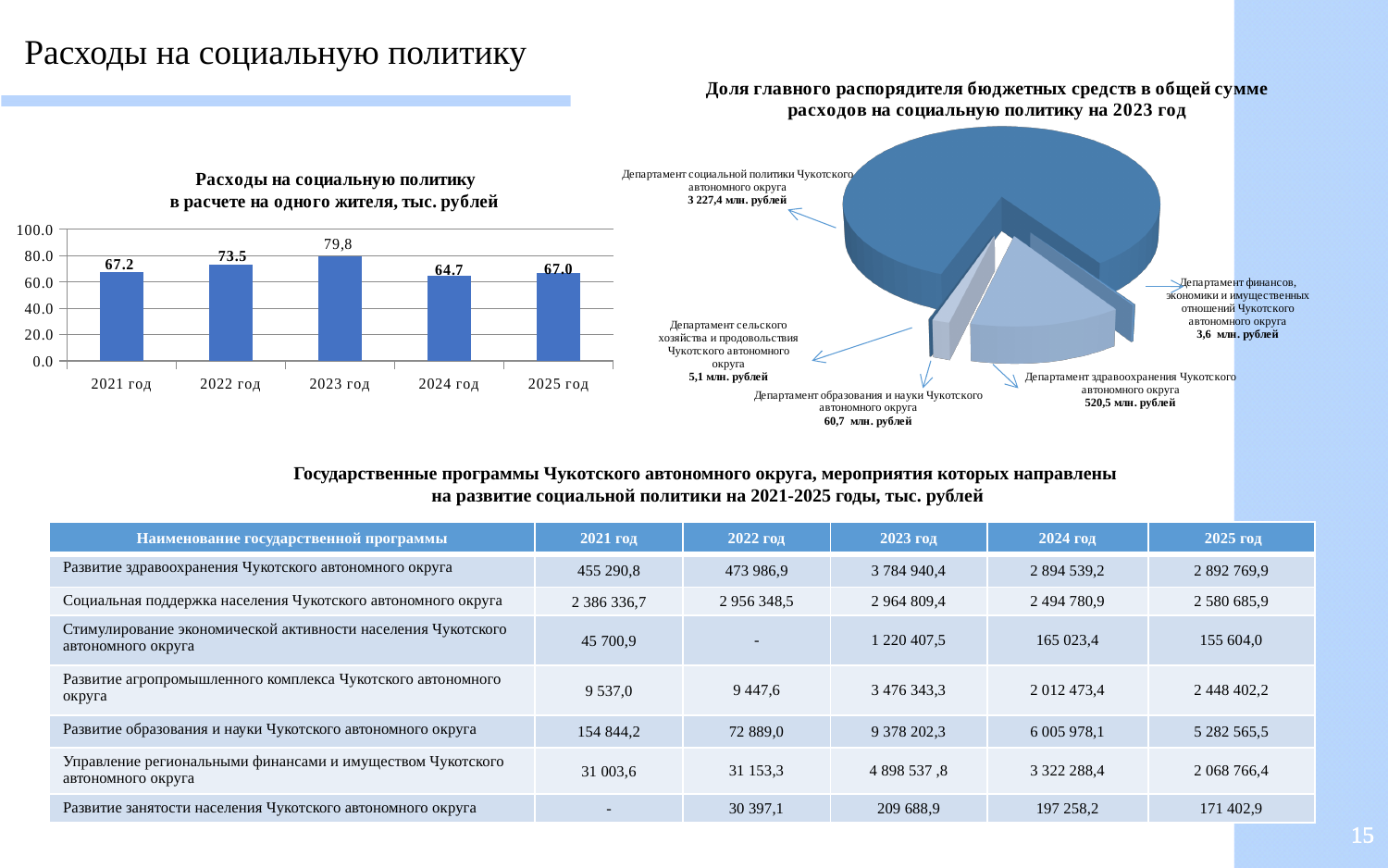
In the bar chart 'Расходы на социальную политику в расчете на одного жителя', how many years are shown on the x axis? 5 In the bar chart 'Расходы на социальную политику в расчете на одного жителя', which year has the highest value? 2023 год In the pie chart on the right, which department has the smallest value? Департамент финансов, экономики и имущественных отношений Чукотского автономного округа In the bar chart 'Расходы на социальную политику в расчете на одного жителя', do the values rise or fall from 2021 год to 2023 год? rise In the pie chart on the right, what value is shown for Департамент здравоохранения Чукотского автономного округа? 520,5 млн. рублей In the bar chart 'Расходы на социальную политику в расчете на одного жителя', what is the difference between the values for 2022 год and 2021 год? 6.3 In the pie chart on the right, which department has the largest share? Департамент социальной политики Чукотского автономного округа In the bar chart 'Расходы на социальную политику в расчете на одного жителя', what is the value for 2021 год? 67.2 In the bar chart 'Расходы на социальную политику в расчете на одного жителя', which year has the lowest value? 2024 год In the bar chart 'Расходы на социальную политику в расчете на одного жителя', which is larger: the value for 2022 год or 2025 год? 2022 год In the bar chart 'Расходы на социальную политику в расчете на одного жителя', what is the value for 2023 год? 79,8 What kind of chart is the chart titled 'Доля главного распорядителя бюджетных средств в общей сумме расходов на социальную политику на 2023 год'? pie chart